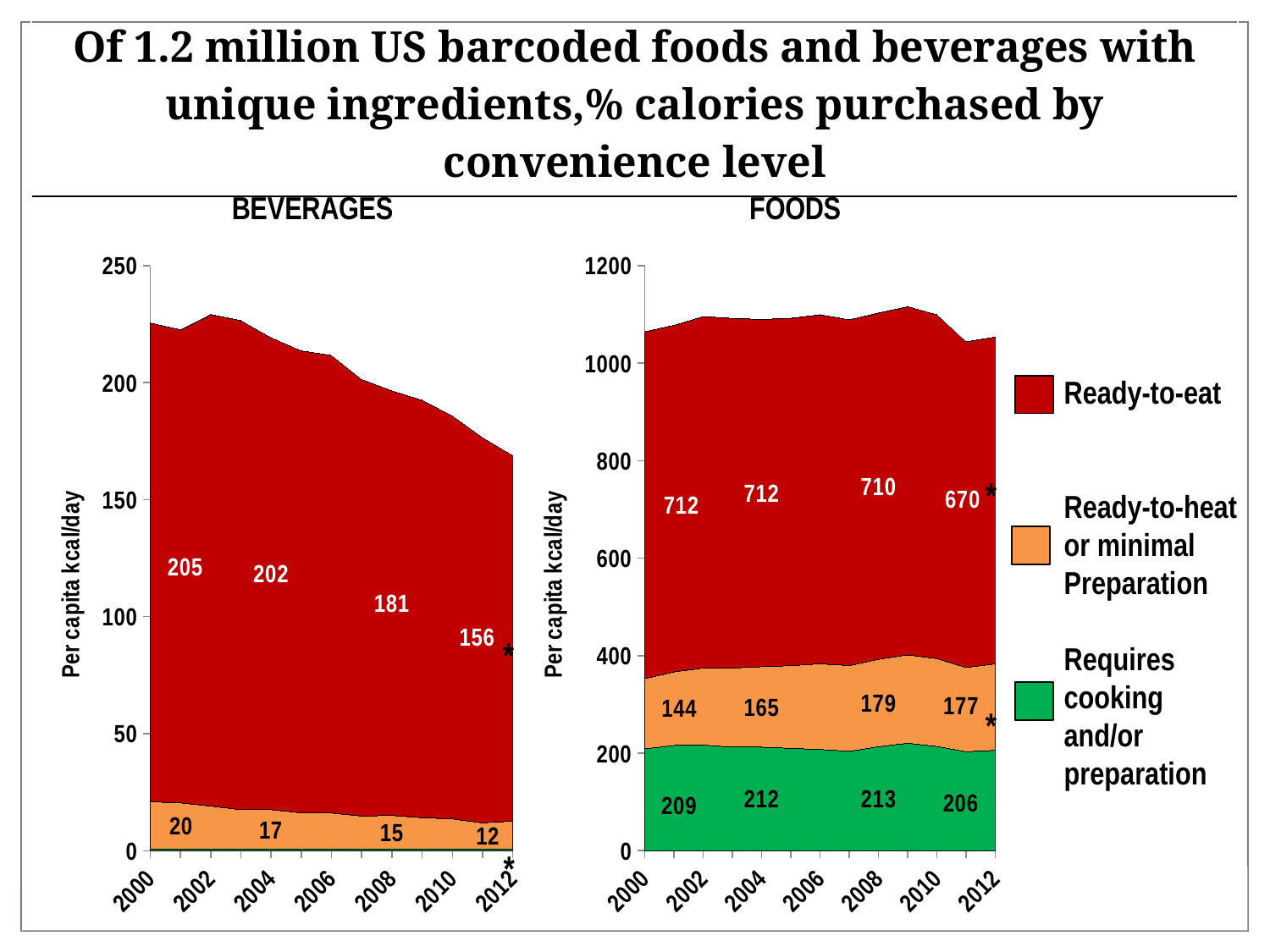
In the FOODS chart, what is the total of the three rightmost labelled values (670, 177 and 206)? 1053 In the BEVERAGES chart, what is the rightmost labelled value for Ready-to-heat or minimal Preparation? 12 In the FOODS chart, what is the rightmost labelled value for Ready-to-eat? 670 In the FOODS chart, is the total stacked value in 2012 greater or less than 1000? greater What kind of chart is the BEVERAGES chart? stacked area chart How many series does the legend list? 3 In the BEVERAGES chart, does the Ready-to-eat value rise or fall from 2000 to 2012? fall In the BEVERAGES chart, what is the difference between the first and last labelled Ready-to-eat values (205 and 156)? 49 In the BEVERAGES chart, what is the last (rightmost, asterisked) labelled value for Ready-to-eat? 156 In the FOODS chart, what is the leftmost labelled value for Requires cooking and/or preparation? 209 In the FOODS chart, which series has the largest labelled values? Ready-to-eat In the BEVERAGES chart, what is the first (leftmost) labelled value for Ready-to-eat? 205